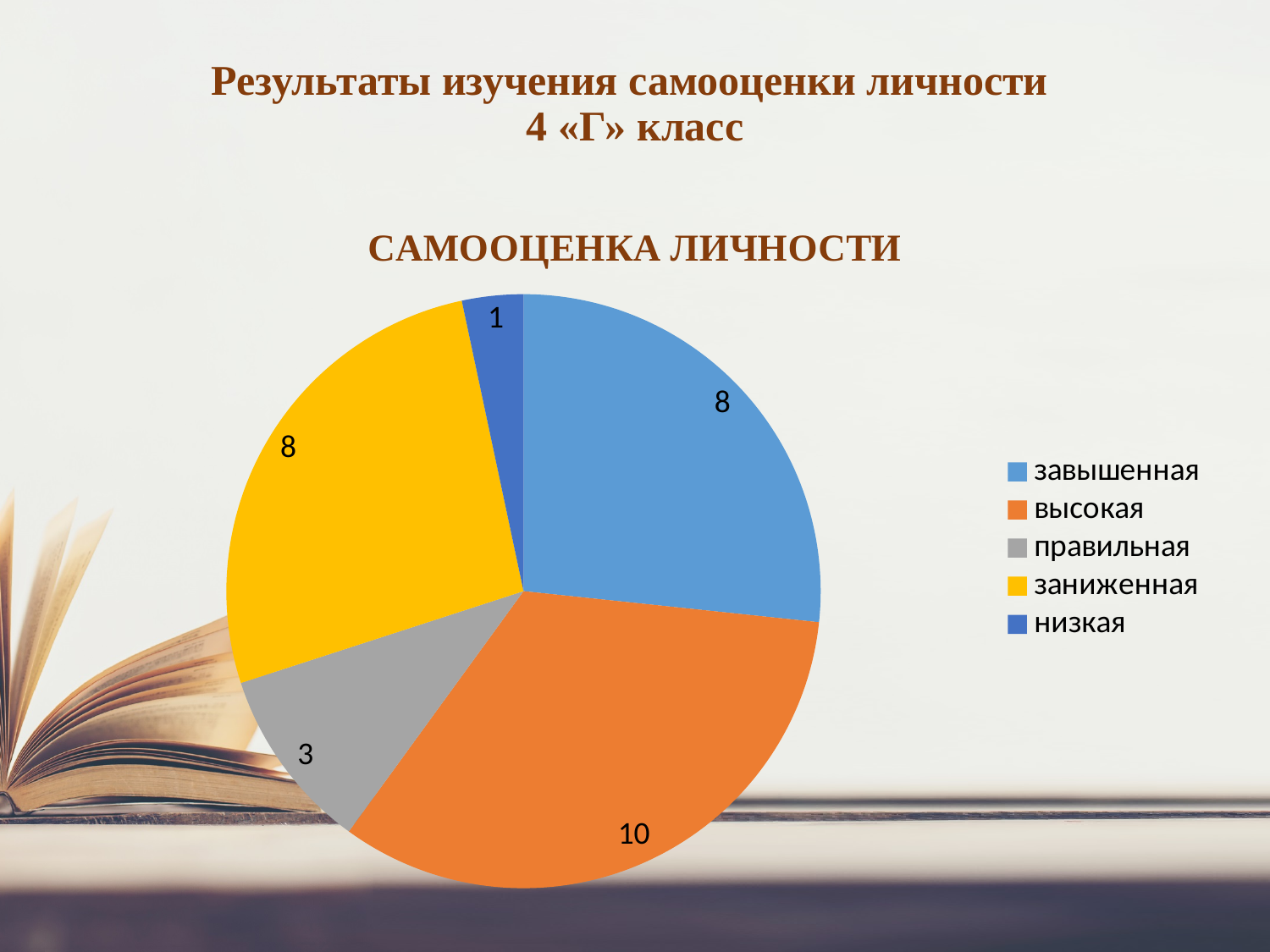
What value is shown for the "правильная" slice? 3 Which category has the smallest slice of the pie? низкая Which category has the largest slice of the pie? высокая What value is shown for the "низкая" slice? 1 Which is larger, the value for "завышенная" or the value for "правильная"? завышенная What is the difference between the values for "высокая" and "правильная"? 7 What is the title of the chart? САМООЦЕНКА ЛИЧНОСТИ What kind of chart is shown on the slide? pie chart What is the difference between the values for "заниженная" and "низкая"? 7 What share of the pie does the "правильная" slice represent? 10% How many categories does the pie chart have? 5 What value is shown for the "высокая" slice? 10